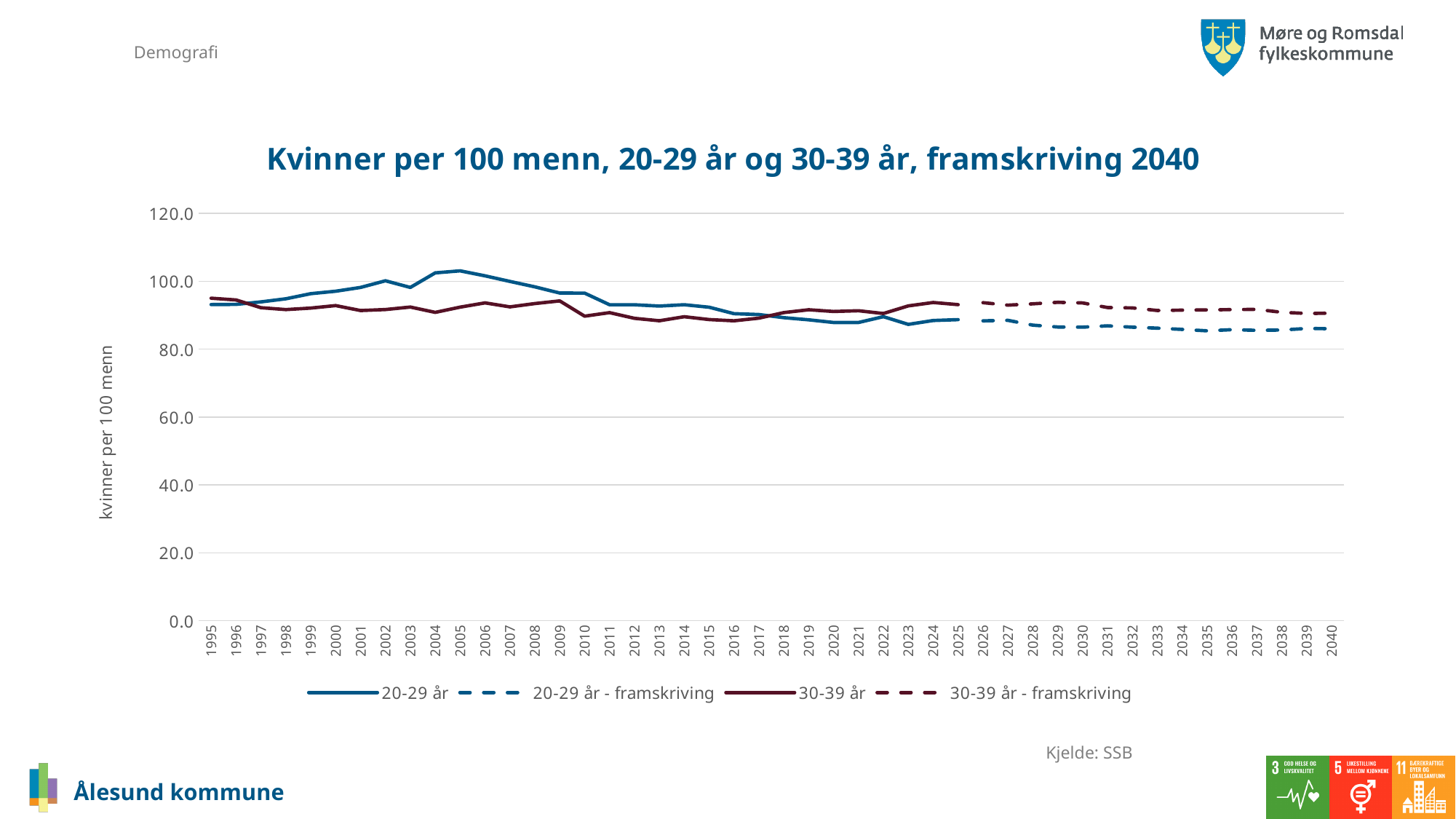
In which year does the 20-29 år series reach its highest value? 2005 What is the title of the chart? Kvinner per 100 menn, 20-29 år og 30-39 år, framskriving 2040 In 2040, which projection is higher, 20-29 år - framskriving or 30-39 år - framskriving? 30-39 år - framskriving Is the value for 20-29 år - framskriving in 2040 greater or less than 90? less What kind of chart is shown on the slide? line chart Is the value for 20-29 år in 2005 greater or less than 100? greater Is the value for 30-39 år - framskriving in 2040 greater or less than 80? greater Does the 20-29 år series rise or fall between 2005 and 2023? fall How many series does the legend list? 4 How many years are labelled on the x axis? 46 In 2005, which series has the higher value, 20-29 år or 30-39 år? 20-29 år What is the label on the y axis? kvinner per 100 menn